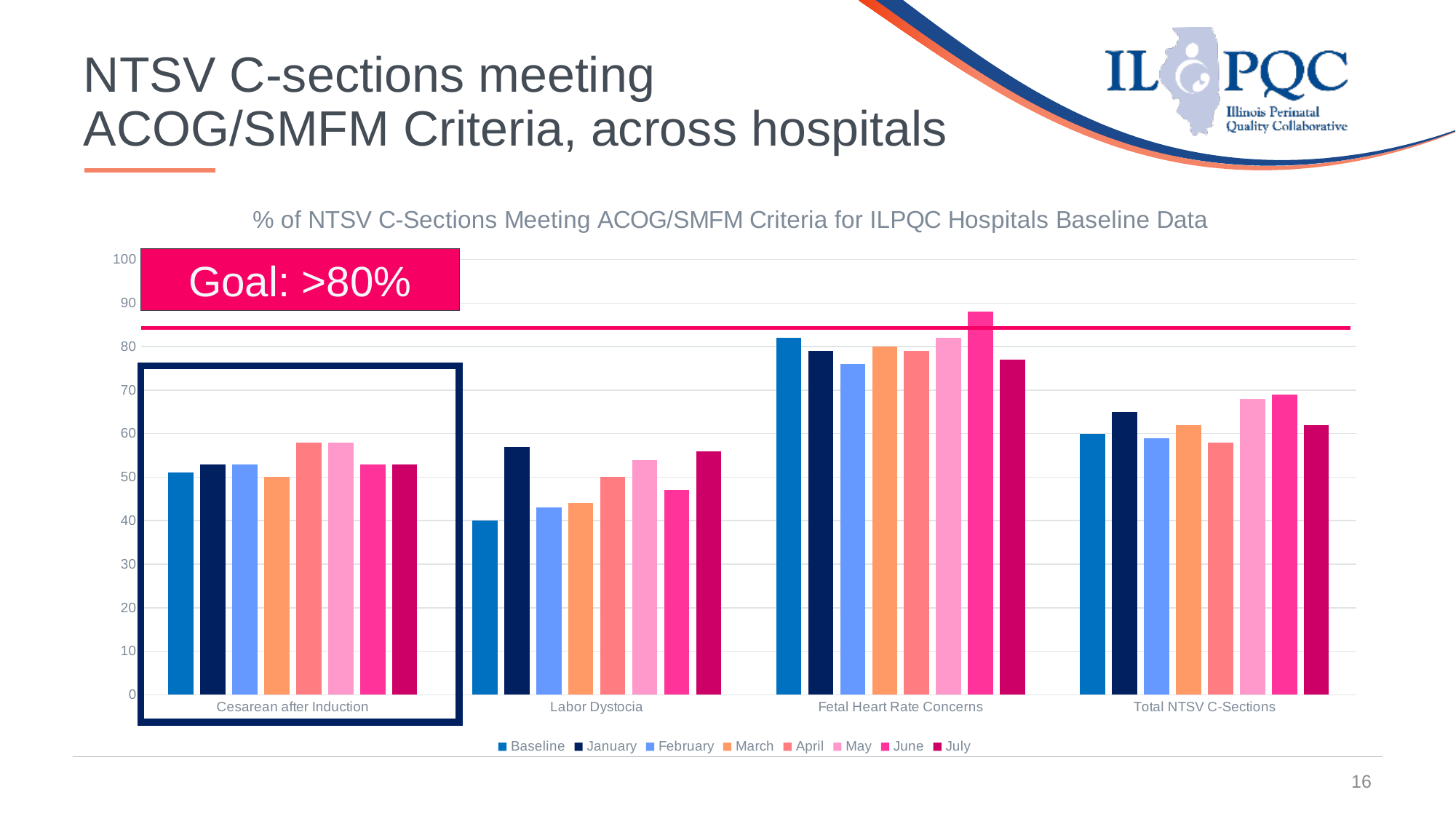
Within the Fetal Heart Rate Concerns category, which series has the highest value? June How many series does the legend list? 8 How many categories are shown on the x axis? 4 Is the Baseline value for Cesarean after Induction greater or less than 60? less What goal is stated in the box on the chart? Goal: >80% Is the June value for Fetal Heart Rate Concerns greater or less than 80? greater Is the Baseline value for Labor Dystocia greater or less than 50? less Which category has the highest June value? Fetal Heart Rate Concerns What kind of chart is shown on the slide? bar chart Within the Labor Dystocia category, which series has the lowest value? Baseline For Labor Dystocia, which is larger: the Baseline value or the January value? January For Total NTSV C-Sections, which is larger: the Baseline value or the May value? May